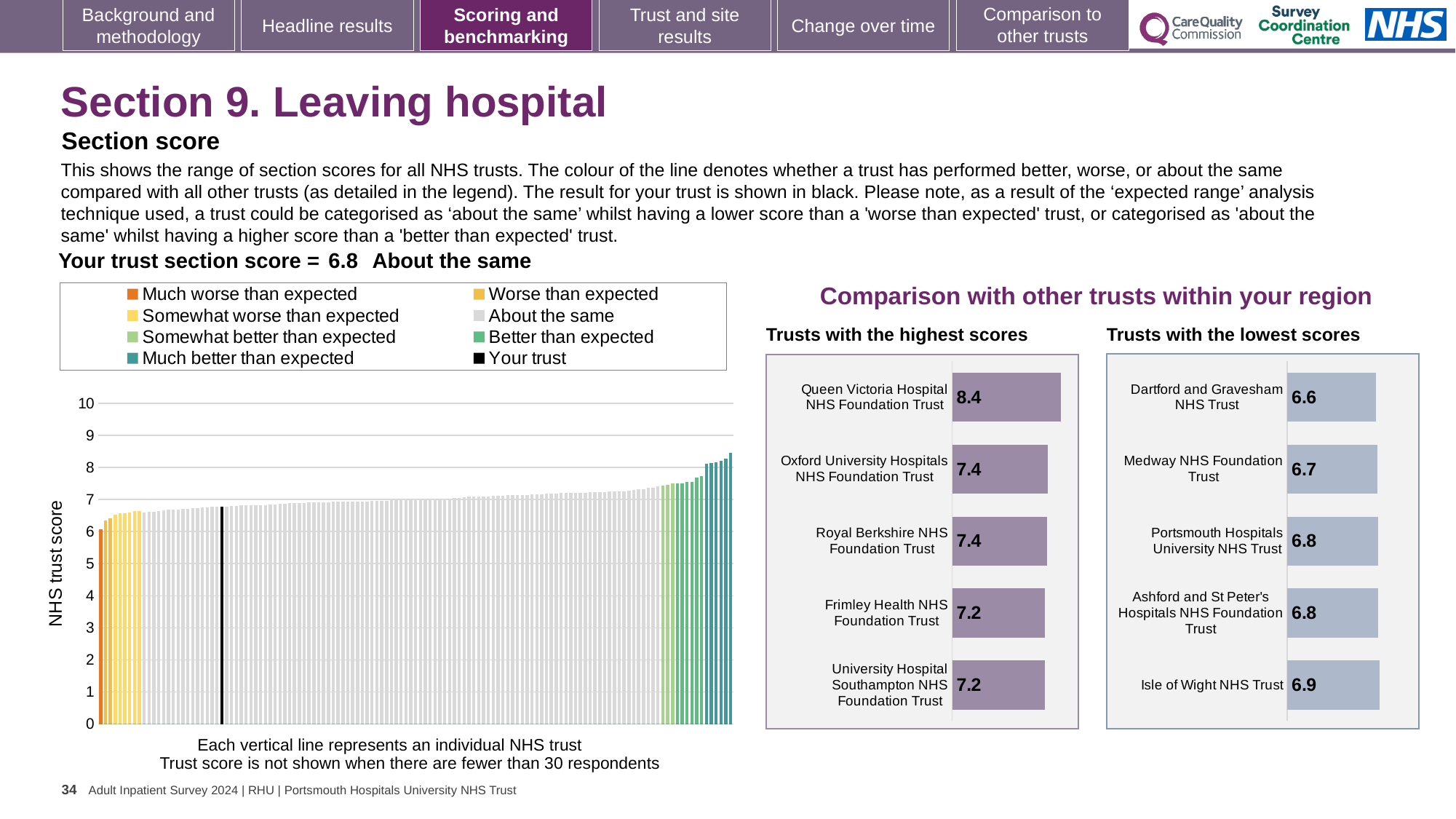
In the 'Trusts with the highest scores' chart, what is the score for Queen Victoria Hospital NHS Foundation Trust? 8.4 In the main section score chart of all NHS trusts, what is the section score for your trust? 6.8 In the 'Trusts with the highest scores' chart, what is the difference between the scores of Queen Victoria Hospital NHS Foundation Trust and Frimley Health NHS Foundation Trust? 1.2 In the 'Trusts with the highest scores' chart, which trust has the highest score? Queen Victoria Hospital NHS Foundation Trust How many entries does the legend of the main section score chart list? 8 What kind of chart is the main section score chart showing all NHS trusts? Bar chart How many trusts are shown in the 'Trusts with the highest scores' chart? 5 In the main section score chart, do the trust scores rise or fall from left to right along the x axis? Rise In the 'Trusts with the lowest scores' chart, which has the larger score: Isle of Wight NHS Trust or Dartford and Gravesham NHS Trust? Isle of Wight NHS Trust In the 'Trusts with the lowest scores' chart, what is the difference between the scores of Isle of Wight NHS Trust and Dartford and Gravesham NHS Trust? 0.3 In the 'Trusts with the lowest scores' chart, what is the score for Medway NHS Foundation Trust? 6.7 In the 'Trusts with the lowest scores' chart, which trust has the lowest score? Dartford and Gravesham NHS Trust